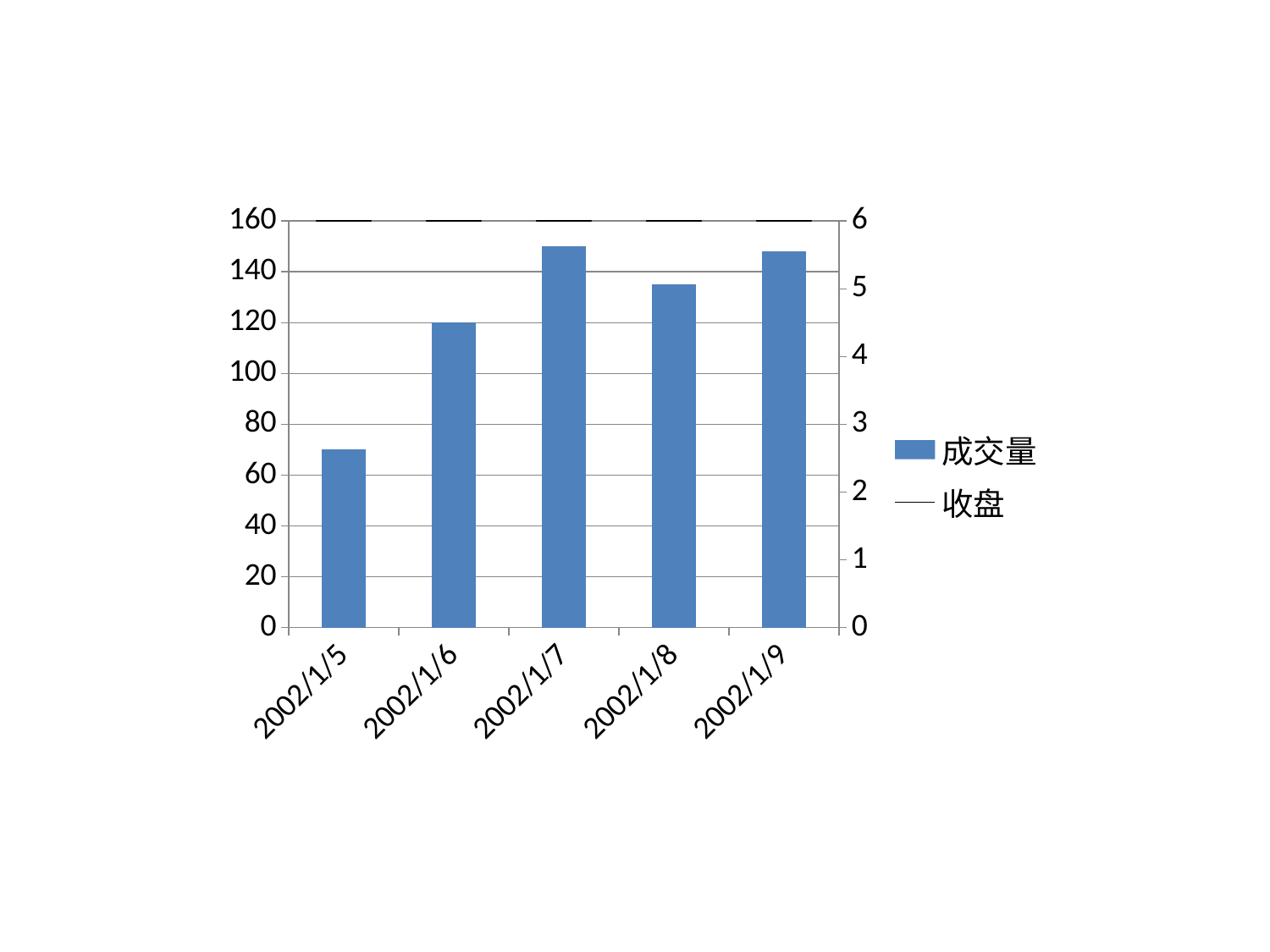
What are the two entries listed in the legend? 成交量 and 收盘 What is the 成交量 value for 2002/1/6? 120 What kind of chart is used to show 成交量? bar chart Is the 成交量 value for 2002/1/9 greater or less than 140? greater Is the 成交量 value for 2002/1/5 greater or less than 80? less Which has the larger 成交量 value, 2002/1/6 or 2002/1/8? 2002/1/8 Is the 成交量 value for 2002/1/8 greater or less than 140? less Which date has the lowest 成交量 bar? 2002/1/5 How many series does the legend list? 2 How many dates are shown on the x axis? 5 Does the 成交量 value rise or fall from 2002/1/5 to 2002/1/6? rise